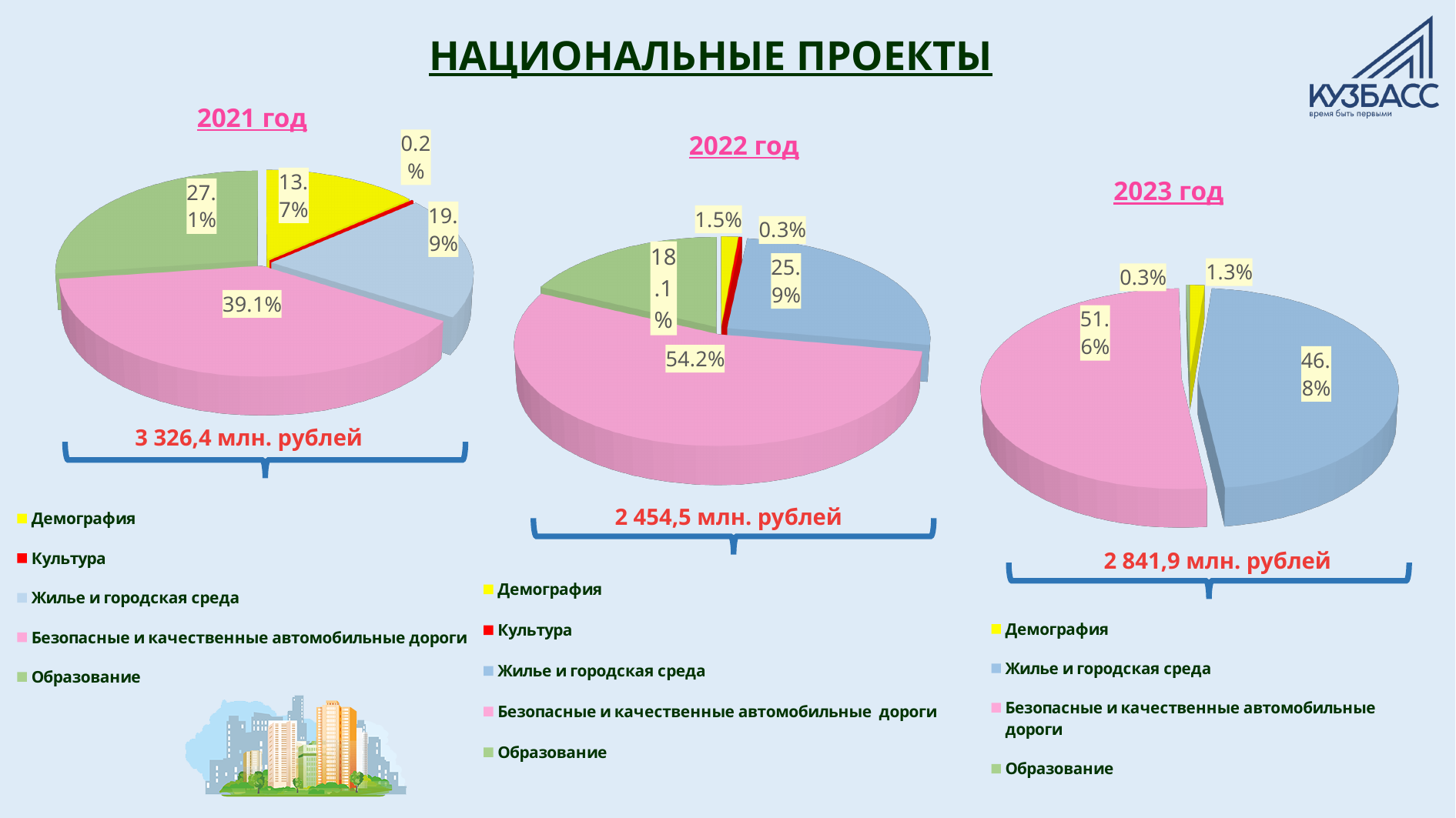
In the 2023 год pie chart, which is larger: Безопасные и качественные автомобильные дороги or Жилье и городская среда? Безопасные и качественные автомобильные дороги In the 2021 год pie chart, which category has the smallest share? Культура In the 2023 год pie chart, what share is shown for Жилье и городская среда? 46.8% In the 2021 год pie chart, what share is shown for Образование? 27.1% What total amount is shown under the 2022 год pie chart? 2 454,5 млн. рублей What total amount is shown under the 2021 год pie chart? 3 326,4 млн. рублей What kind of chart is used for the 2022 год data? Pie chart In the 2021 год pie chart, what share is shown for Безопасные и качественные автомобильные дороги? 39.1% In the 2022 год pie chart, which category has the largest share? Безопасные и качественные автомобильные дороги In the 2022 год pie chart, what is the difference between the shares of Безопасные и качественные автомобильные дороги and Образование? 36.1% How many categories does the legend of the 2023 год pie chart list? 4